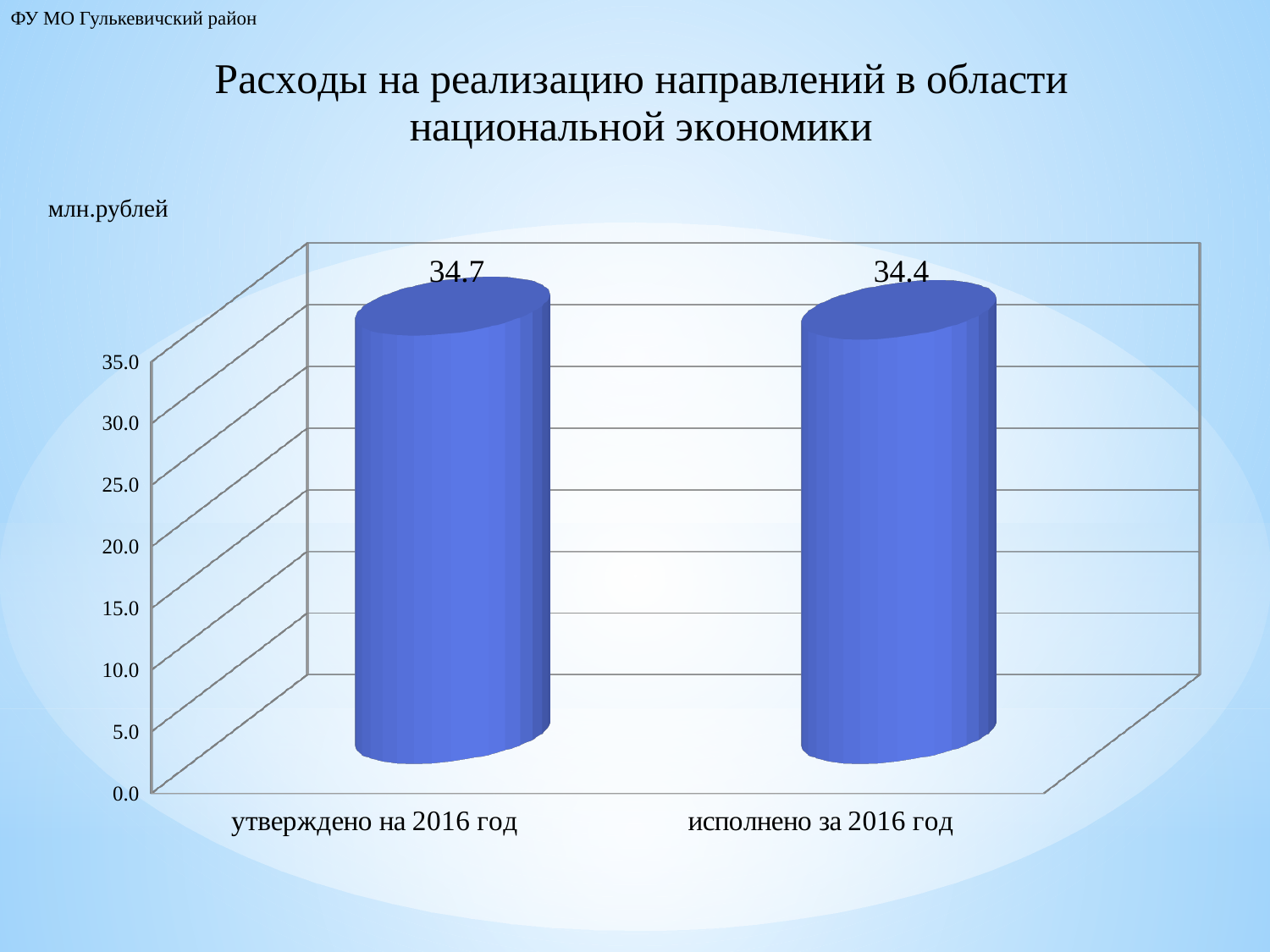
Is the value for «утверждено на 2016 год» greater or less than 25.0? greater What is the value for «исполнено за 2016 год»? 34.4 What is the title of the chart? Расходы на реализацию направлений в области национальной экономики Which category has the highest value? утверждено на 2016 год Is the value for «исполнено за 2016 год» greater or less than 30.0? greater Which category has the lowest value? исполнено за 2016 год What kind of chart is shown on the slide? bar chart What is the value for «утверждено на 2016 год»? 34.7 What is the difference between the value for «утверждено на 2016 год» and the value for «исполнено за 2016 год»? 0.3 How many categories are shown on the chart? 2 What unit of measurement is indicated for the chart values? млн.рублей Which category has the higher value, «утверждено на 2016 год» or «исполнено за 2016 год»? утверждено на 2016 год